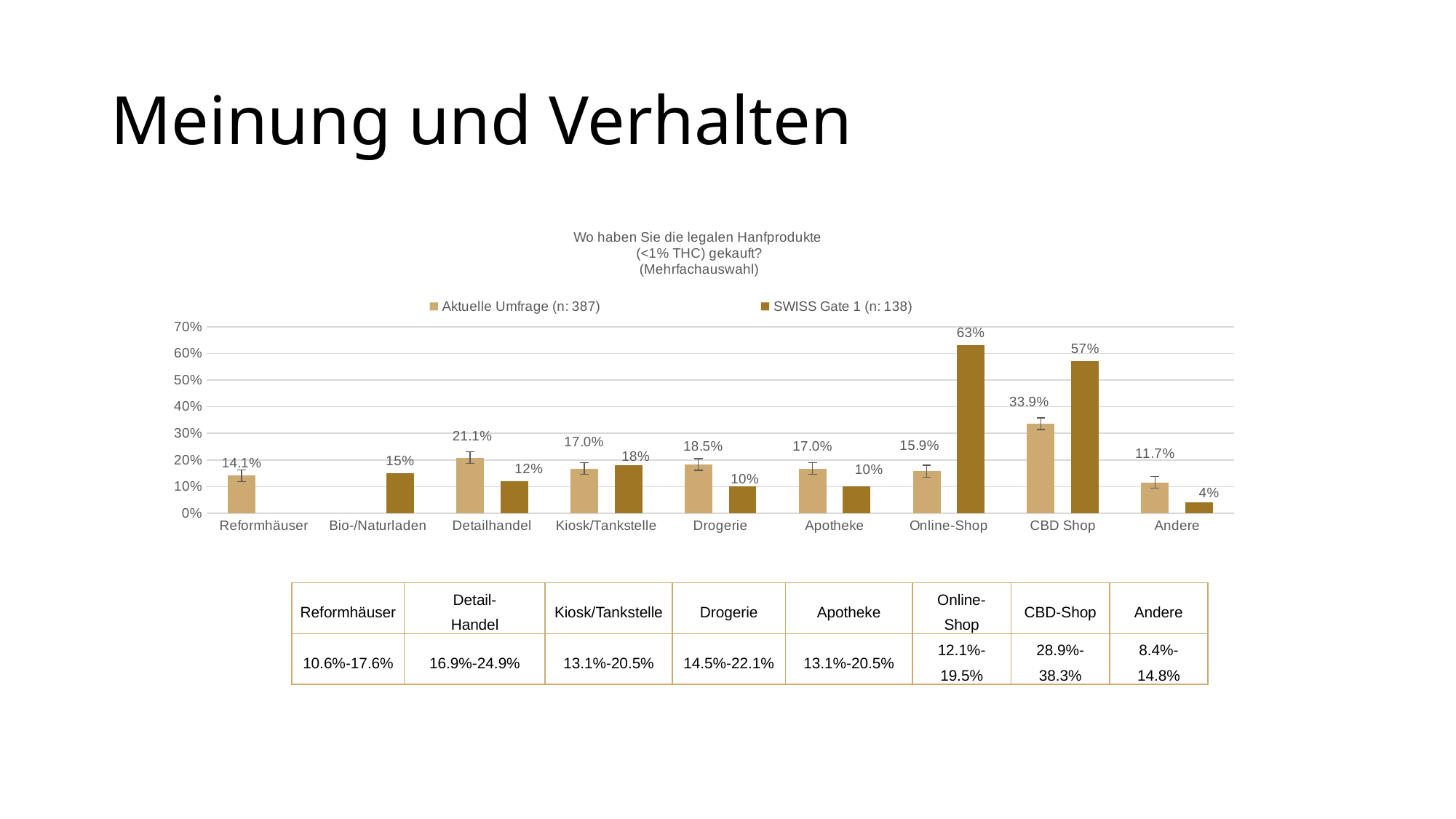
What is the difference between the SWISS Gate 1 (n: 138) and Aktuelle Umfrage (n: 387) values for Online-Shop? 47.1% What kind of chart is shown on the slide? Bar chart Which is larger for Detailhandel: the Aktuelle Umfrage (n: 387) value or the SWISS Gate 1 (n: 138) value? Aktuelle Umfrage (n: 387) Is the SWISS Gate 1 (n: 138) value for CBD Shop greater or less than 50%? greater Which category has the lowest value in the SWISS Gate 1 (n: 138) series? Andere What is the value for Andere in the SWISS Gate 1 (n: 138) series? 4% Which category has the highest value in the Aktuelle Umfrage (n: 387) series? CBD Shop How many categories are shown on the x axis of the chart? 9 What is the value for Online-Shop in the SWISS Gate 1 (n: 138) series? 63% What is the value for CBD Shop in the Aktuelle Umfrage (n: 387) series? 33.9% What is the value for Drogerie in the Aktuelle Umfrage (n: 387) series? 18.5% How many series does the chart legend list? 2